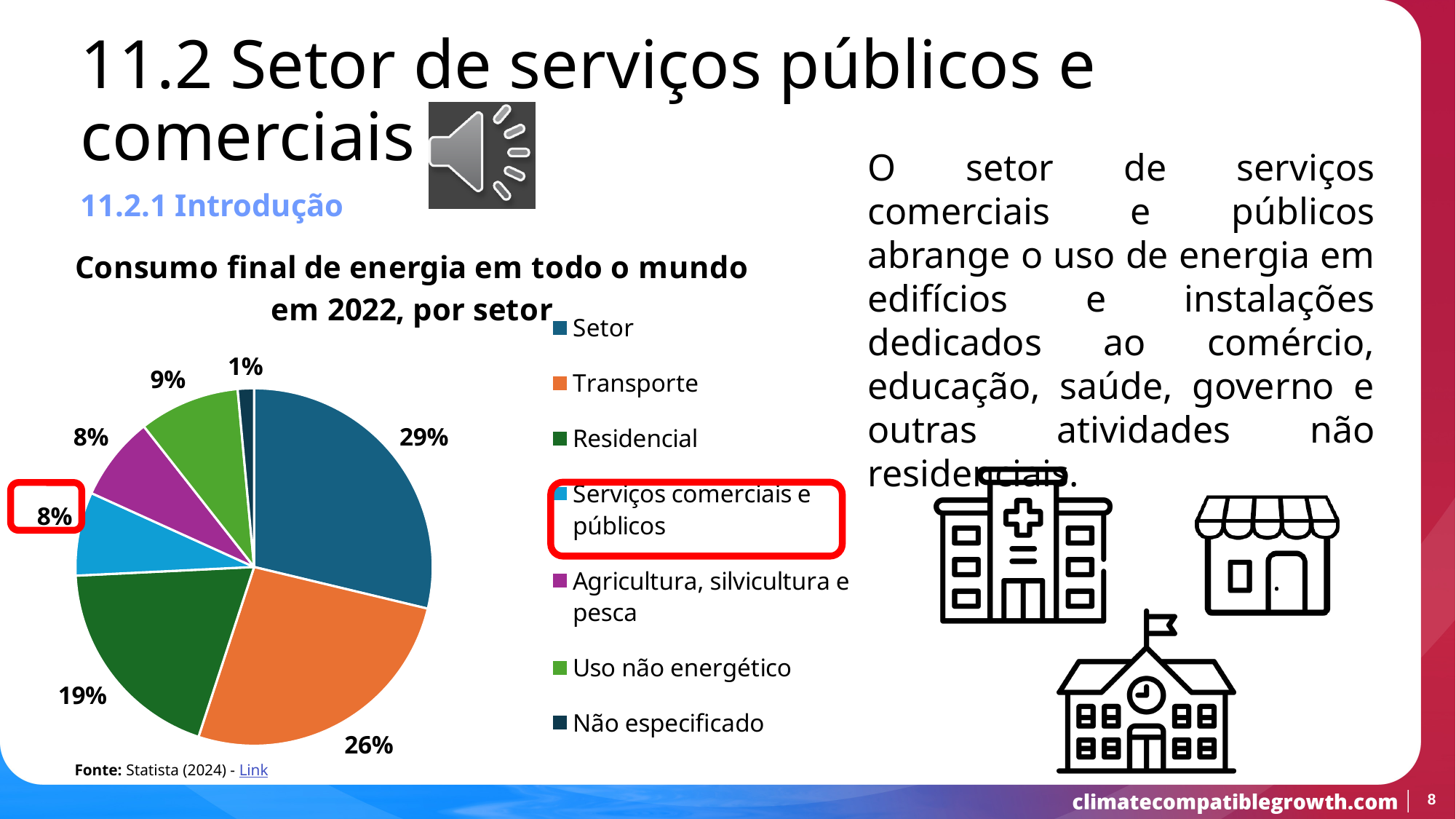
Which category has the largest slice of the pie? Setor Which is larger, Residencial or Uso não energético? Residencial Which category has the smallest slice of the pie? Não especificado What is the value for Serviços comerciais e públicos? 8% What is the value for Não especificado? 1% What is the value for Residencial? 19% What share of the pie does Transporte have? 26% What is the title of the chart? Consumo final de energia em todo o mundo em 2022, por setor What kind of chart is shown on the slide? pie chart What is the difference between the values for Setor and Transporte? 3% How many categories does the legend list? 7 What is the value for Uso não energético? 9%